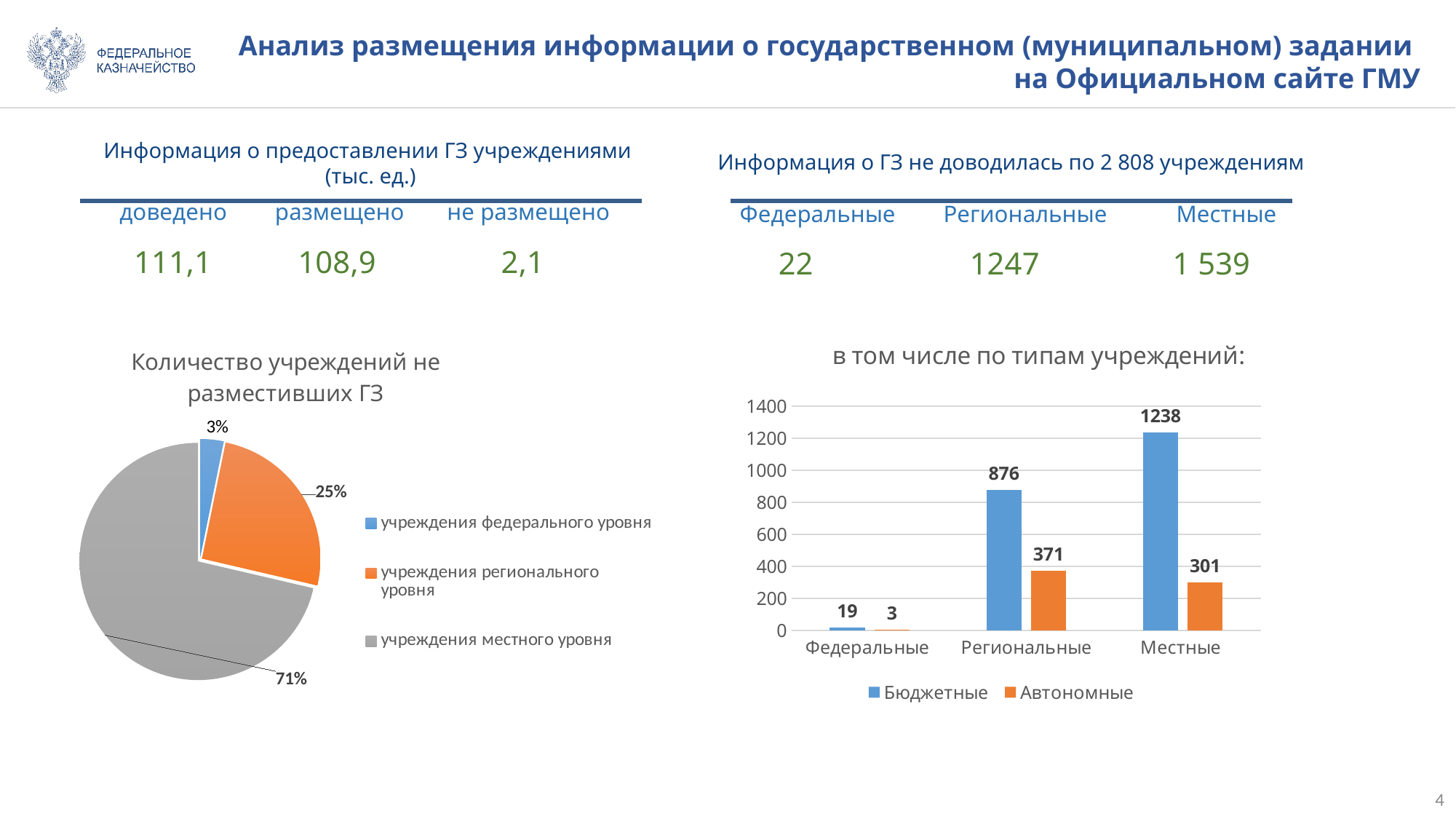
In the bar chart 'в том числе по типам учреждений', what is the value for Бюджетные in the Региональные category? 876 In the bar chart 'в том числе по типам учреждений', what is the difference between Бюджетные and Автономные in the Местные category? 937 In the bar chart 'в том числе по типам учреждений', which category has the highest Бюджетные value? Местные In the bar chart 'в том числе по типам учреждений', what is the value for Автономные in the Местные category? 301 In the bar chart 'в том числе по типам учреждений', how many series does the legend list? 2 In the bar chart 'в том числе по типам учреждений', which is larger in the Региональные category: Бюджетные or Автономные? Бюджетные What type of chart is 'в том числе по типам учреждений'? bar chart In the pie chart 'Количество учреждений не разместивших ГЗ', which category has the smallest slice? учреждения федерального уровня In the pie chart 'Количество учреждений не разместивших ГЗ', what share do учреждения местного уровня have? 71% In the pie chart 'Количество учреждений не разместивших ГЗ', how many slices are there? 3 In the bar chart 'в том числе по типам учреждений', what is the total of Бюджетные and Автономные for the Федеральные category? 22 In the pie chart 'Количество учреждений не разместивших ГЗ', what share do учреждения регионального уровня have? 25%